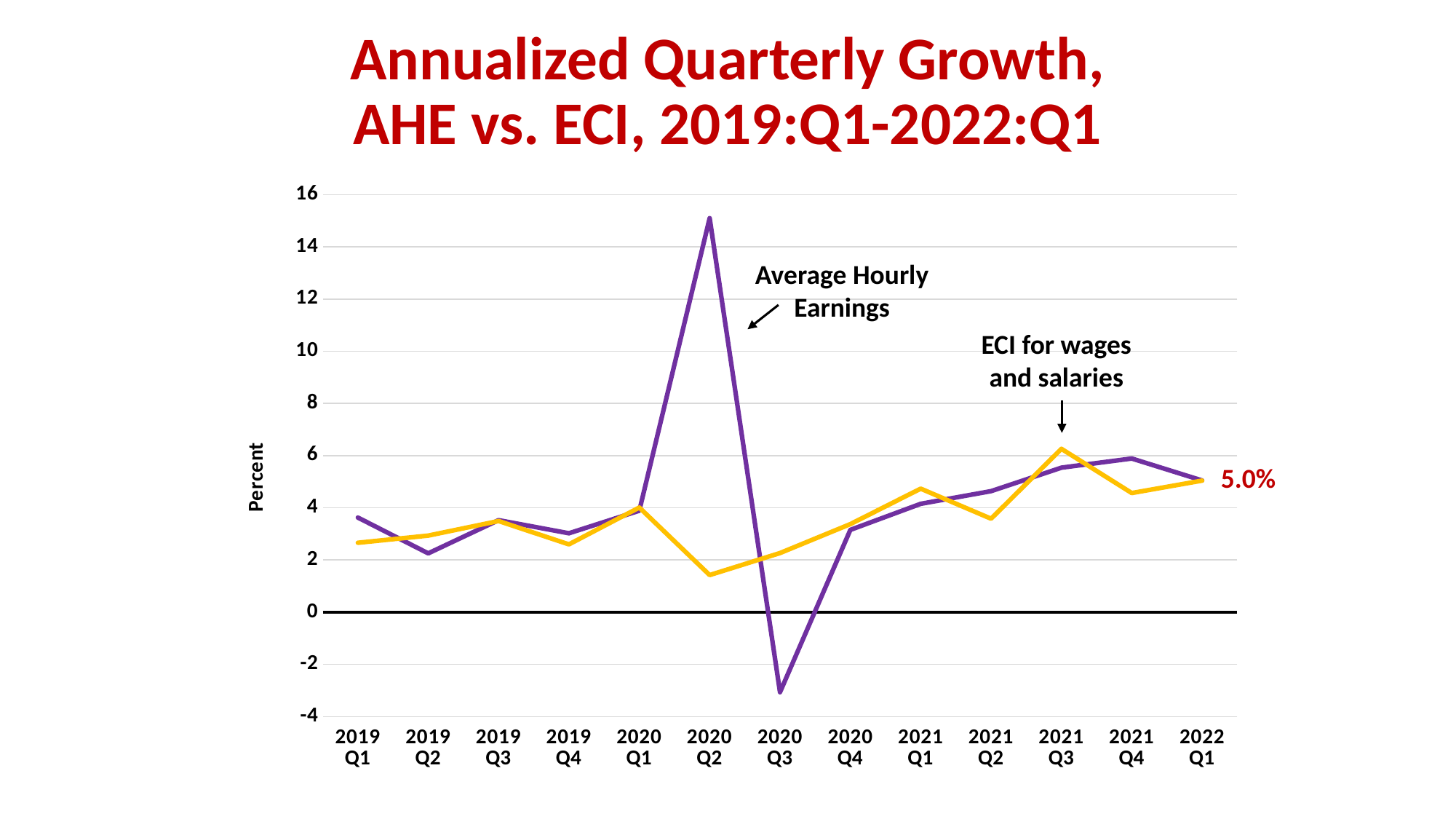
How many series are plotted in the chart? 2 Is the value for Average Hourly Earnings in 2020 Q2 greater or less than 14? greater What type of chart is shown on the slide? line chart In which quarter does Average Hourly Earnings reach its lowest value? 2020 Q3 Is the value for Average Hourly Earnings in 2020 Q3 greater or less than -2? less How many quarters are plotted along the x axis? 13 What is the label on the y axis of the chart? Percent In 2020 Q3, which series has the larger value, Average Hourly Earnings or ECI for wages and salaries? ECI for wages and salaries In which quarter does Average Hourly Earnings reach its highest value? 2020 Q2 In which quarter does ECI for wages and salaries reach its highest value? 2021 Q3 Is the value for ECI for wages and salaries in 2020 Q2 greater or less than 2? less In which quarter does ECI for wages and salaries reach its lowest value? 2020 Q2